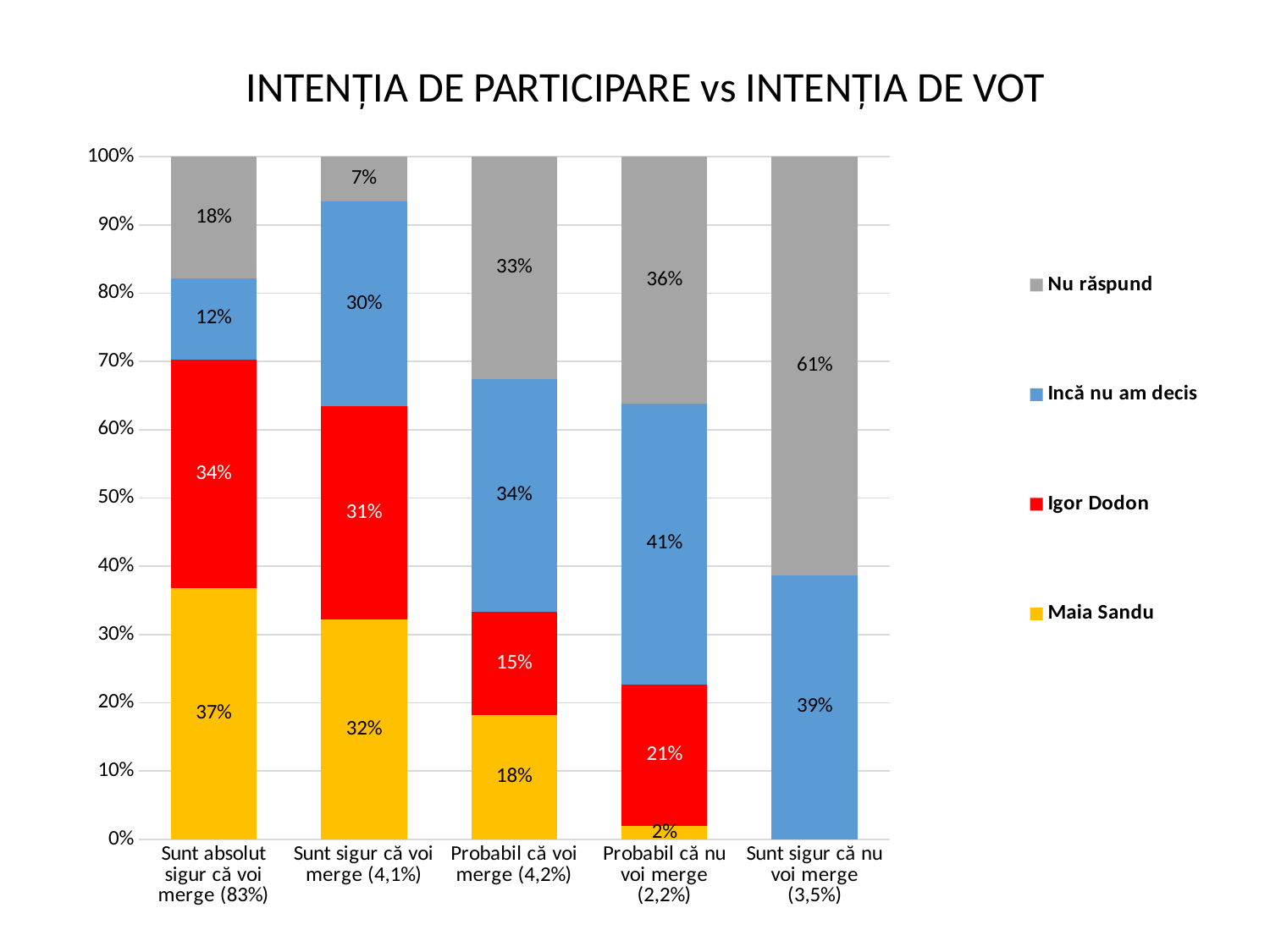
What is the Igor Dodon value for the "Probabil că nu voi merge (2,2%)" category? 21% What kind of chart is shown on the slide? Stacked bar chart Which category has the larger "Incă nu am decis" share: "Probabil că voi merge (4,2%)" or "Probabil că nu voi merge (2,2%)"? Probabil că nu voi merge (2,2%) How many categories are shown on the x axis? 5 What is the "Nu răspund" share in the "Sunt sigur că nu voi merge (3,5%)" category? 61% What colour represents Igor Dodon in the chart? Red Which category has the highest "Nu răspund" share? Sunt sigur că nu voi merge (3,5%) How many series does the legend list? 4 What is the "Incă nu am decis" value for the "Sunt sigur că voi merge (4,1%)" category? 30% Which category has the lowest "Nu răspund" share? Sunt sigur că voi merge (4,1%) What percentage of respondents in the "Sunt absolut sigur că voi merge (83%)" category intend to vote for Maia Sandu? 37% In the "Sunt absolut sigur că voi merge (83%)" category, how many percentage points higher is Maia Sandu than Igor Dodon? 3 percentage points